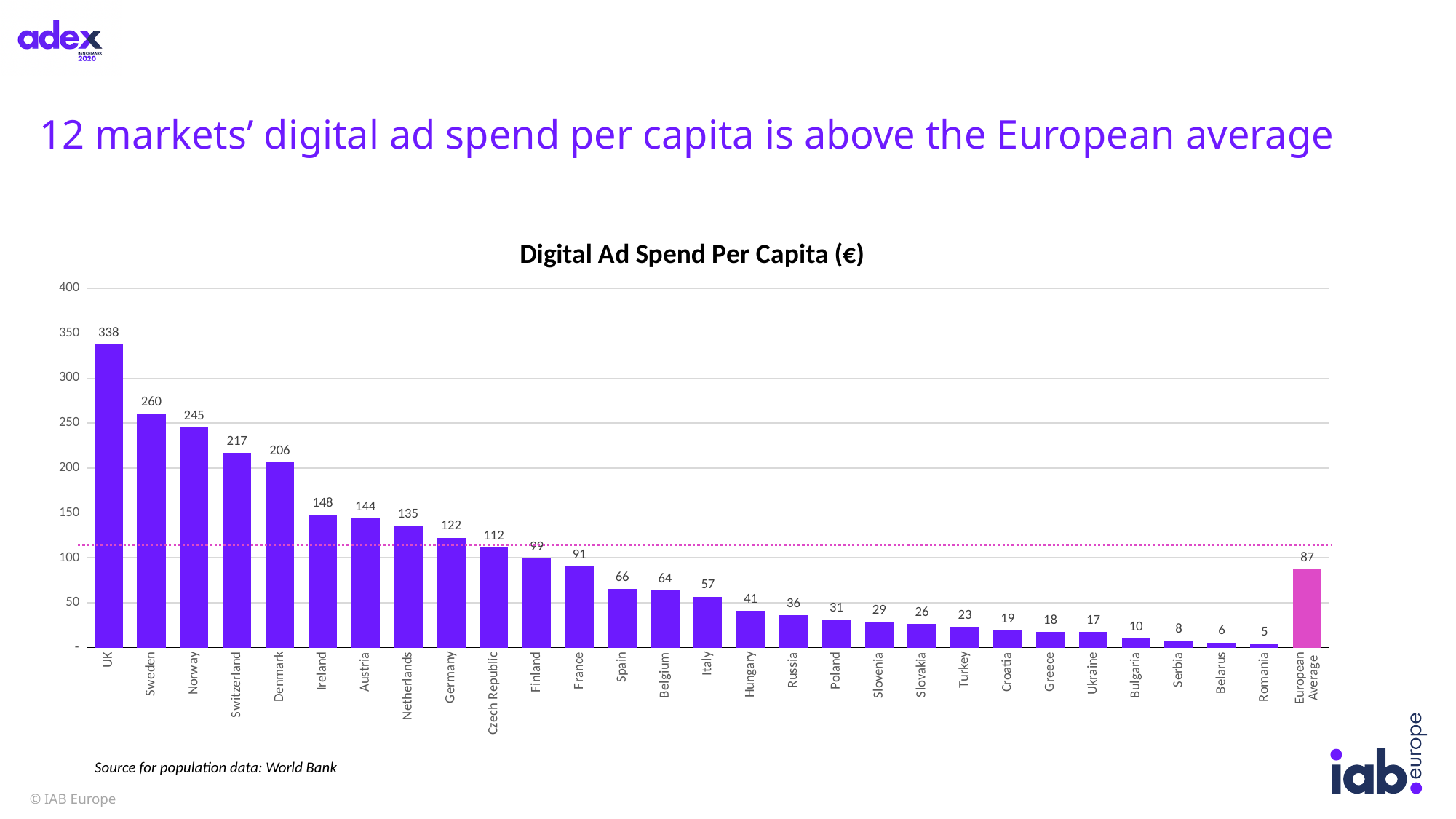
What is the digital ad spend per capita for the UK? 338 What is the difference between Sweden's and Norway's digital ad spend per capita? 15 Which market has the lowest digital ad spend per capita? Romania What type of chart is shown on the slide? Bar chart How many bars are plotted in the chart, including the European Average? 29 Which market has the highest digital ad spend per capita? UK What is the digital ad spend per capita for Germany? 122 Which has a higher digital ad spend per capita, France or Spain? France What is the value shown for the European Average bar? 87 Is the value for Ireland greater or less than 100? greater What is the title of the chart? Digital Ad Spend Per Capita (€) What is the difference between the UK's value and the European Average? 251